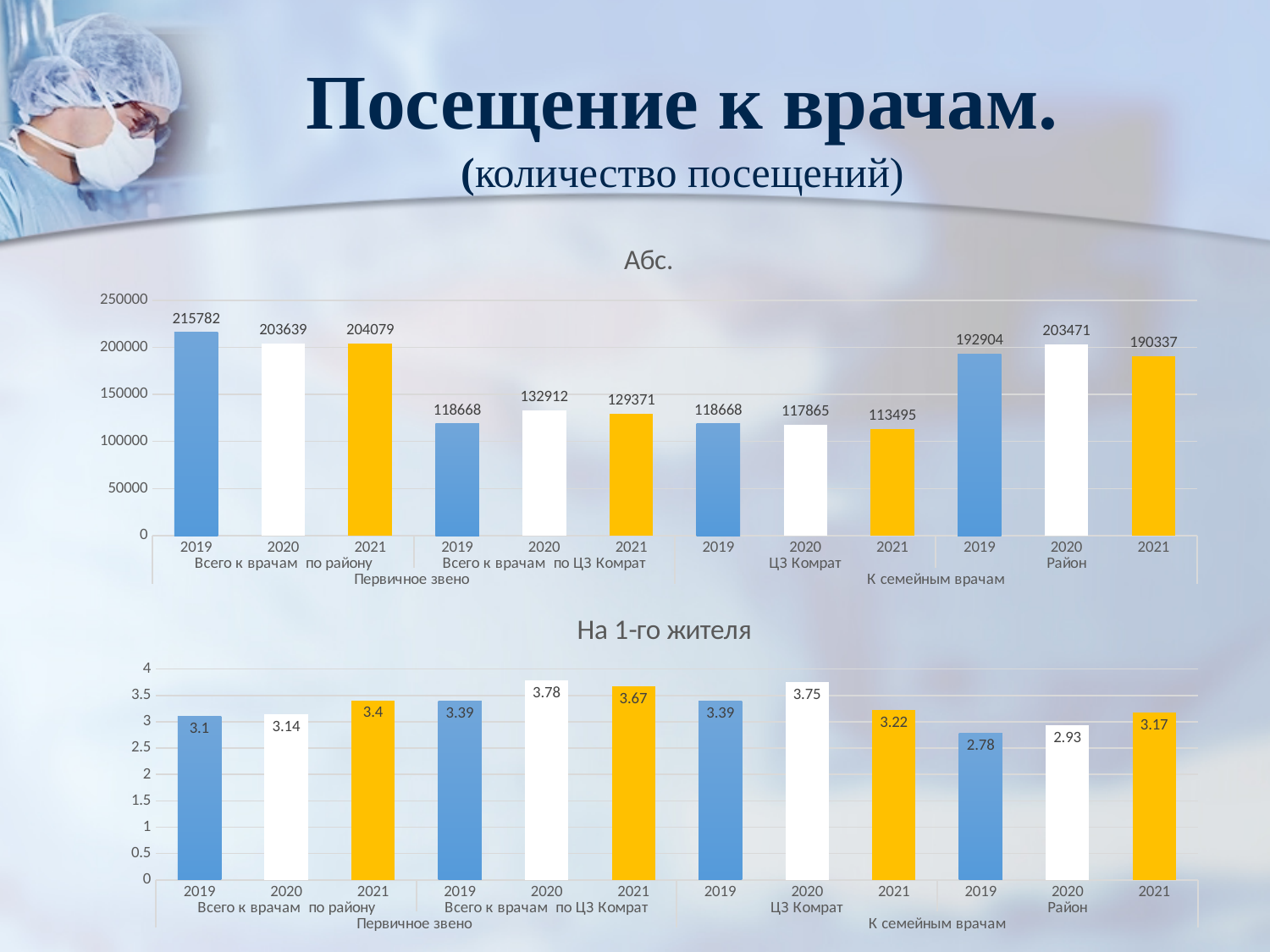
In the "Абс." chart, what is the value for 2021 under "Район" (К семейным врачам)? 190337 In the "На 1-го жителя" chart, what is the value for 2019 under "Район" (К семейным врачам)? 2.78 In the "На 1-го жителя" chart, which is larger: the 2020 value under "ЦЗ Комрат" or the 2021 value under "ЦЗ Комрат"? 2020 (3.75) In the "Абс." chart, what is the value for 2020 under "Всего к врачам по ЦЗ Комрат"? 132912 What type of chart is the "На 1-го жителя" chart? bar chart In the "Абс." chart, what is the difference between the 2019 and 2021 values under "Всего к врачам по району"? 11703 In the "На 1-го жителя" chart, what is the value for 2020 under "Всего к врачам по ЦЗ Комрат"? 3.78 In the "Абс." chart, which bar has the highest value? 2019, Всего к врачам по району (215782) In the "Абс." chart, how many bars are plotted? 12 In the "Абс." chart, what is the value for 2019 under "Всего к врачам по району"? 215782 In the "Абс." chart, which bar has the lowest value? 2021, ЦЗ Комрат (113495) In the "На 1-го жителя" chart, do the values under "Район" (К семейным врачам) rise or fall from 2019 to 2021? rise